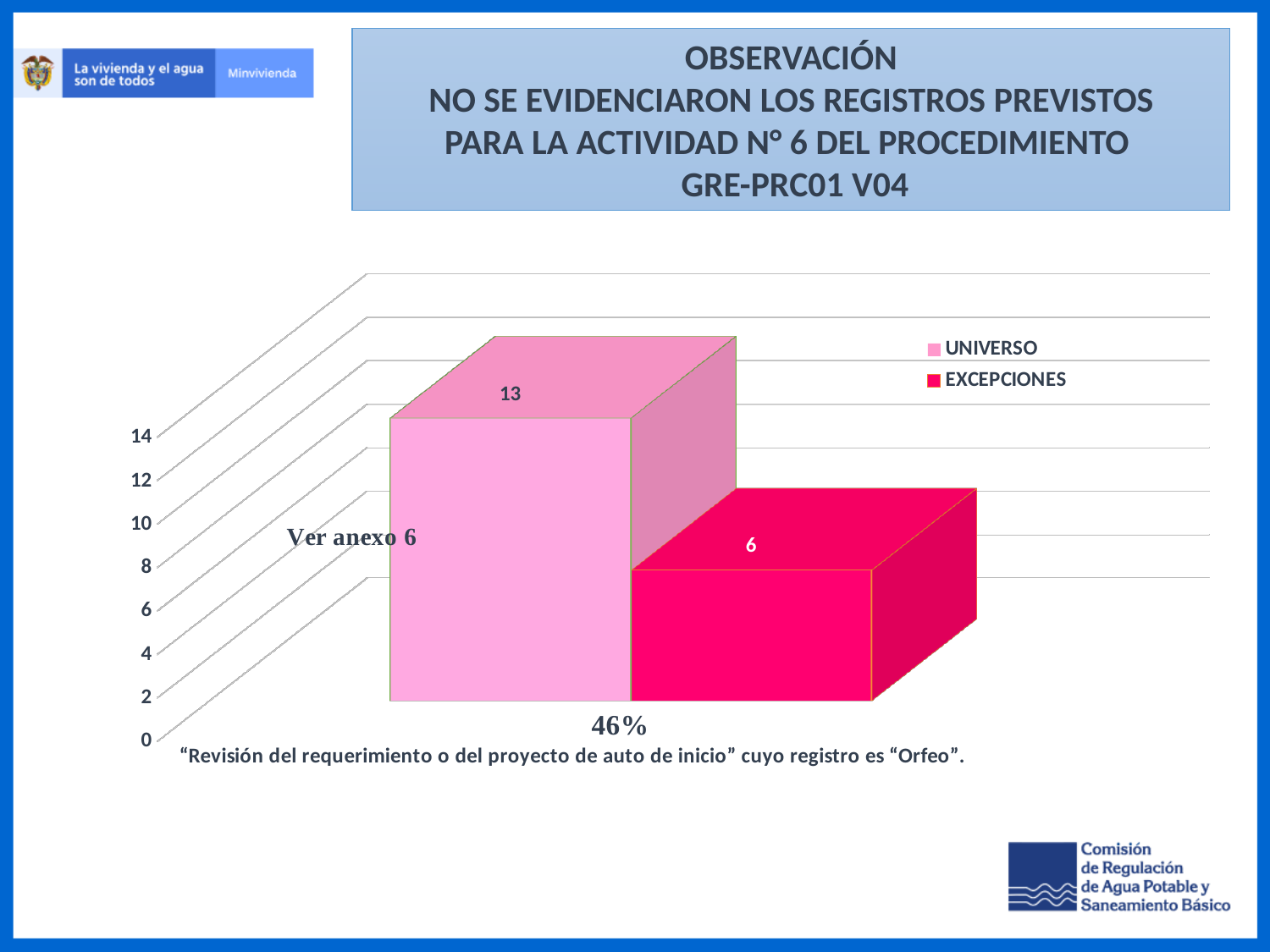
Is the value for EXCEPCIONES greater or less than 8? less Is the value for UNIVERSO greater or less than 10? greater What is the difference between the UNIVERSO value and the EXCEPCIONES value? 7 Which series has the higher value, UNIVERSO or EXCEPCIONES? UNIVERSO What is the value for UNIVERSO? 13 What kind of chart is shown on the slide? bar chart What is the highest value shown on the vertical axis? 14 How many series does the legend list? 2 Which series has the lowest value? EXCEPCIONES What percentage is printed below the bars? 46% What is the value for EXCEPCIONES? 6